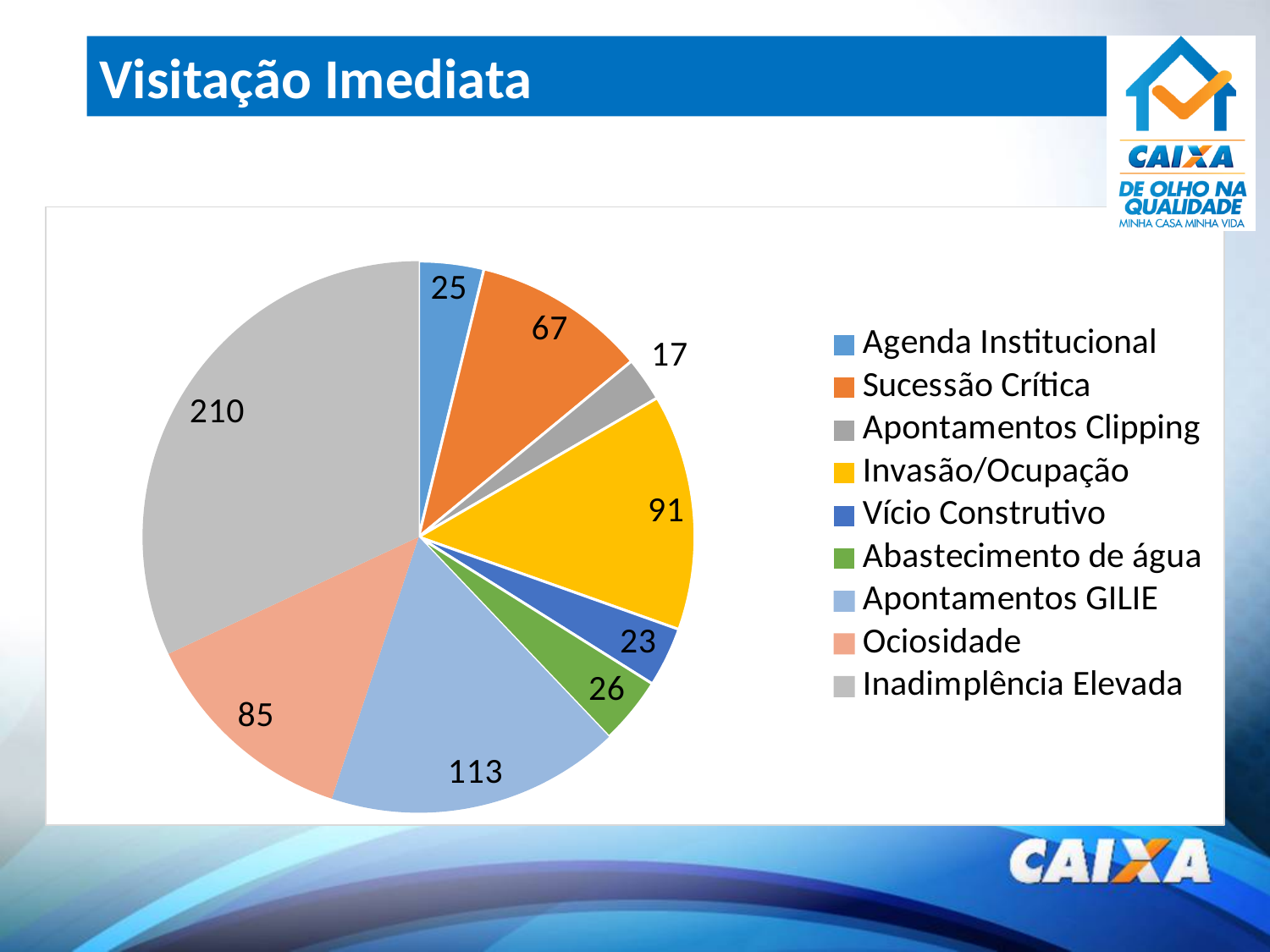
Which category has the largest slice? Inadimplência Elevada What is the difference between the values for Inadimplência Elevada and Apontamentos GILIE? 97 What type of chart is shown on the slide? pie chart What is the value for Inadimplência Elevada? 210 What colour is the slice for Invasão/Ocupação? yellow Which is larger, Sucessão Crítica or Ociosidade? Ociosidade What is the total of all slices in the pie chart? 657 What is the value for Invasão/Ocupação? 91 What is the value for Apontamentos Clipping? 17 What is the value for Apontamentos GILIE? 113 How many categories does the pie chart have? 9 Which category has the smallest slice? Apontamentos Clipping